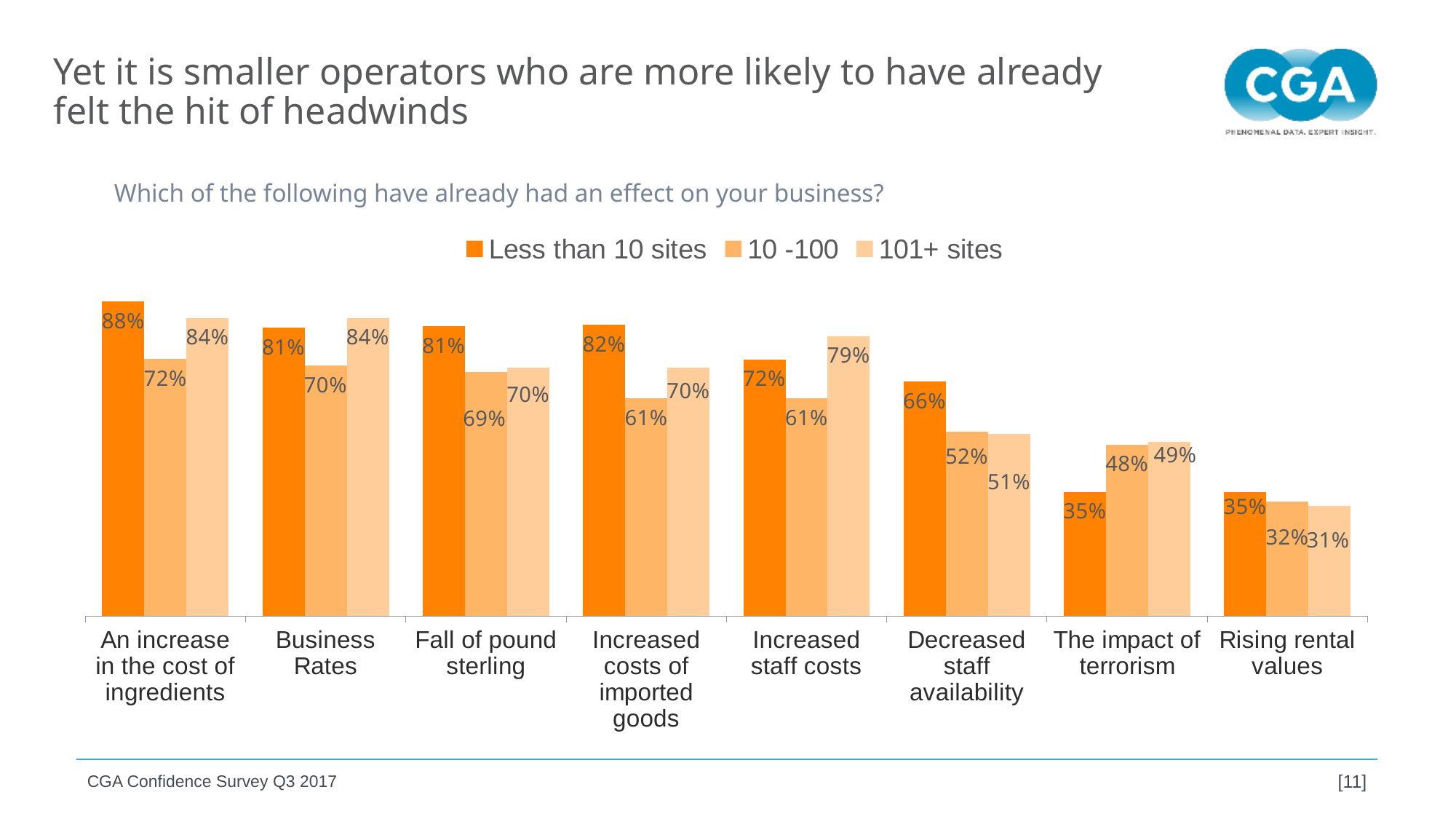
What kind of chart is shown on the slide? Bar chart What question is the chart based on, as shown above the chart? Which of the following have already had an effect on your business? For Business Rates, which is larger: the value for Less than 10 sites or the value for 101+ sites? 101+ sites What is the value for 10 -100 sites for Decreased staff availability? 52% For The impact of terrorism, which is larger: the value for 10 -100 or the value for 101+ sites? 101+ sites Which category has the lowest value for the 101+ sites series? Rising rental values What percentage of operators with less than 10 sites said an increase in the cost of ingredients has already had an effect on their business? 88% How many categories are shown on the x axis of the chart? 8 How many series does the legend list? 3 What is the value for 101+ sites for Increased staff costs? 79% Which category has the highest value for the Less than 10 sites series? An increase in the cost of ingredients What is the difference between the Less than 10 sites value and the 10 -100 value for Increased costs of imported goods? 21%